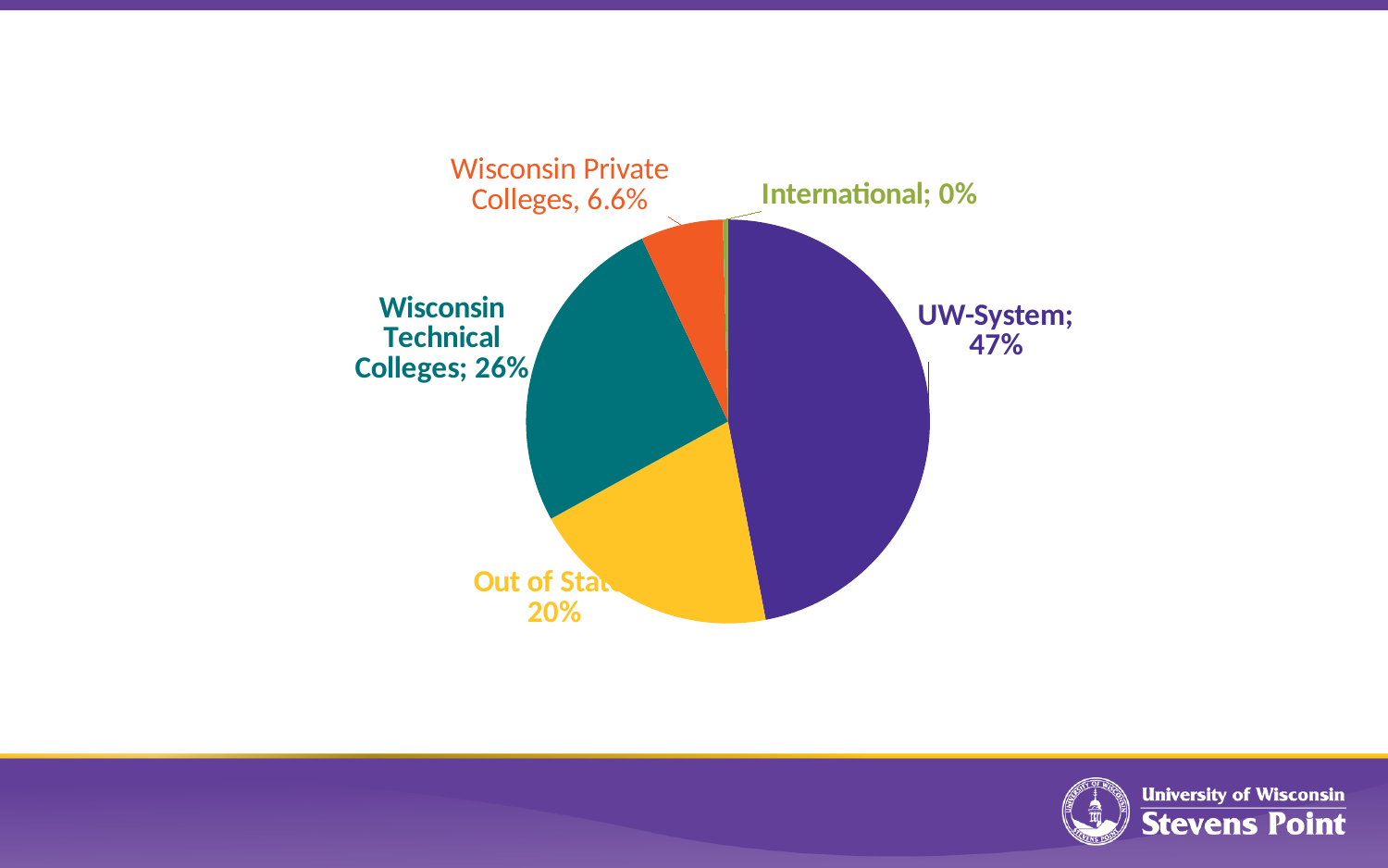
What colour is the UW-System slice? Purple What percentage is shown for Wisconsin Private Colleges? 6.6% Which category has the smallest slice of the pie? International What kind of chart is shown on the slide? Pie chart What percentage is shown for International? 0% Which is larger, the share for Wisconsin Technical Colleges or the share for Out of State? Wisconsin Technical Colleges What share of the pie does UW-System hold? 47% What is the difference in percentage points between UW-System and Wisconsin Technical Colleges? 21 Which category has the largest slice of the pie? UW-System What percentage is shown for Wisconsin Technical Colleges? 26% What percentage is shown for Out of State? 20% How many categories are shown in the pie chart? 5